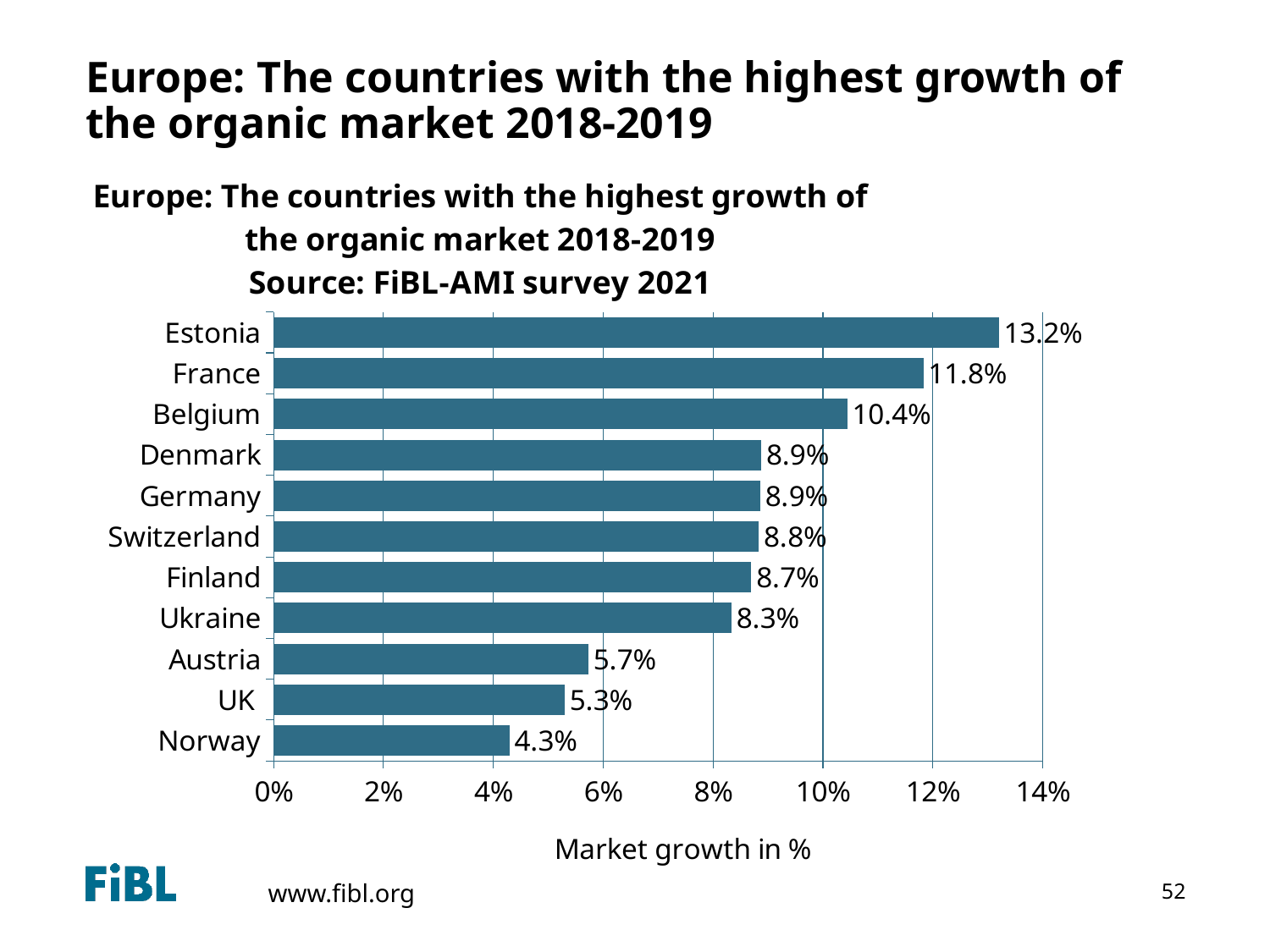
What is the difference in market growth between Austria and the UK? 0.4% What type of chart is shown on the slide? Bar chart How many countries are shown in the chart? 11 What is the difference in market growth between Estonia and France? 1.4% What is the market growth value for Estonia? 13.2% What is the market growth value for Belgium? 10.4% Which has a higher market growth, Belgium or Finland? Belgium Which country has the highest market growth? Estonia Which country has the lowest market growth? Norway What is the label of the horizontal axis? Market growth in % What is the market growth value for Norway? 4.3% What is the market growth value for Ukraine? 8.3%